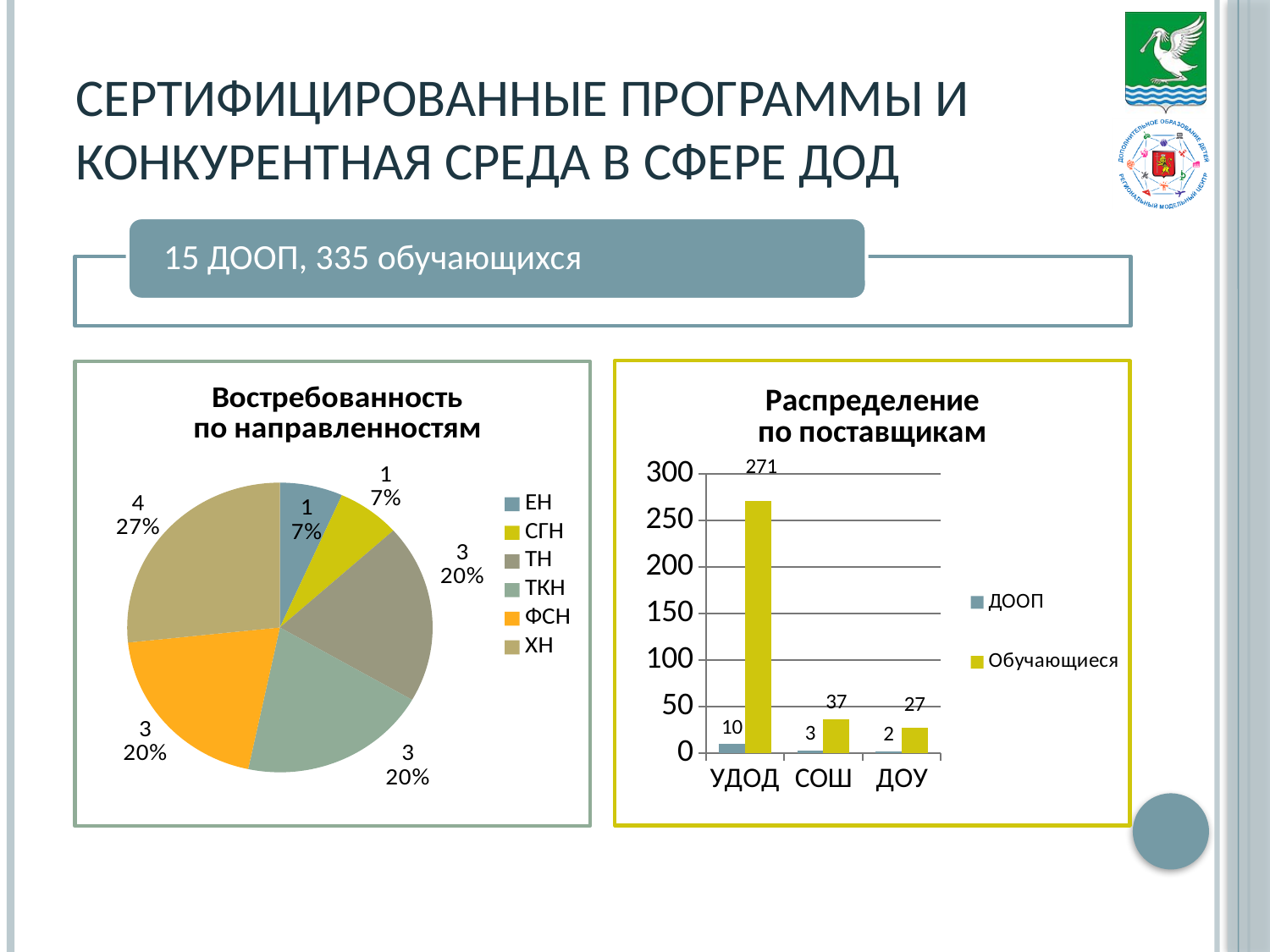
In the chart 'Распределение по поставщикам', how many categories are shown on the x axis? 3 In the pie chart 'Востребованность по направленностям', how many categories does the legend list? 6 In the chart 'Распределение по поставщикам', what is the value of Обучающиеся for УДОД? 271 In the pie chart 'Востребованность по направленностям', which category has the largest slice? ХН In the chart 'Распределение по поставщикам', which category has the lowest value for ДООП? ДОУ In the chart 'Распределение по поставщикам', what is the value of Обучающиеся for ДОУ? 27 In the chart 'Распределение по поставщикам', how many series does the legend list? 2 In the chart 'Распределение по поставщикам', which category has the highest value for Обучающиеся? УДОД In the chart 'Распределение по поставщикам', what is the difference between Обучающиеся for СОШ and for ДОУ? 10 What kind of chart is 'Распределение по поставщикам'? bar chart In the chart 'Распределение по поставщикам', what is the value of ДООП for СОШ? 3 In the pie chart 'Востребованность по направленностям', what share does ХН have? 27%